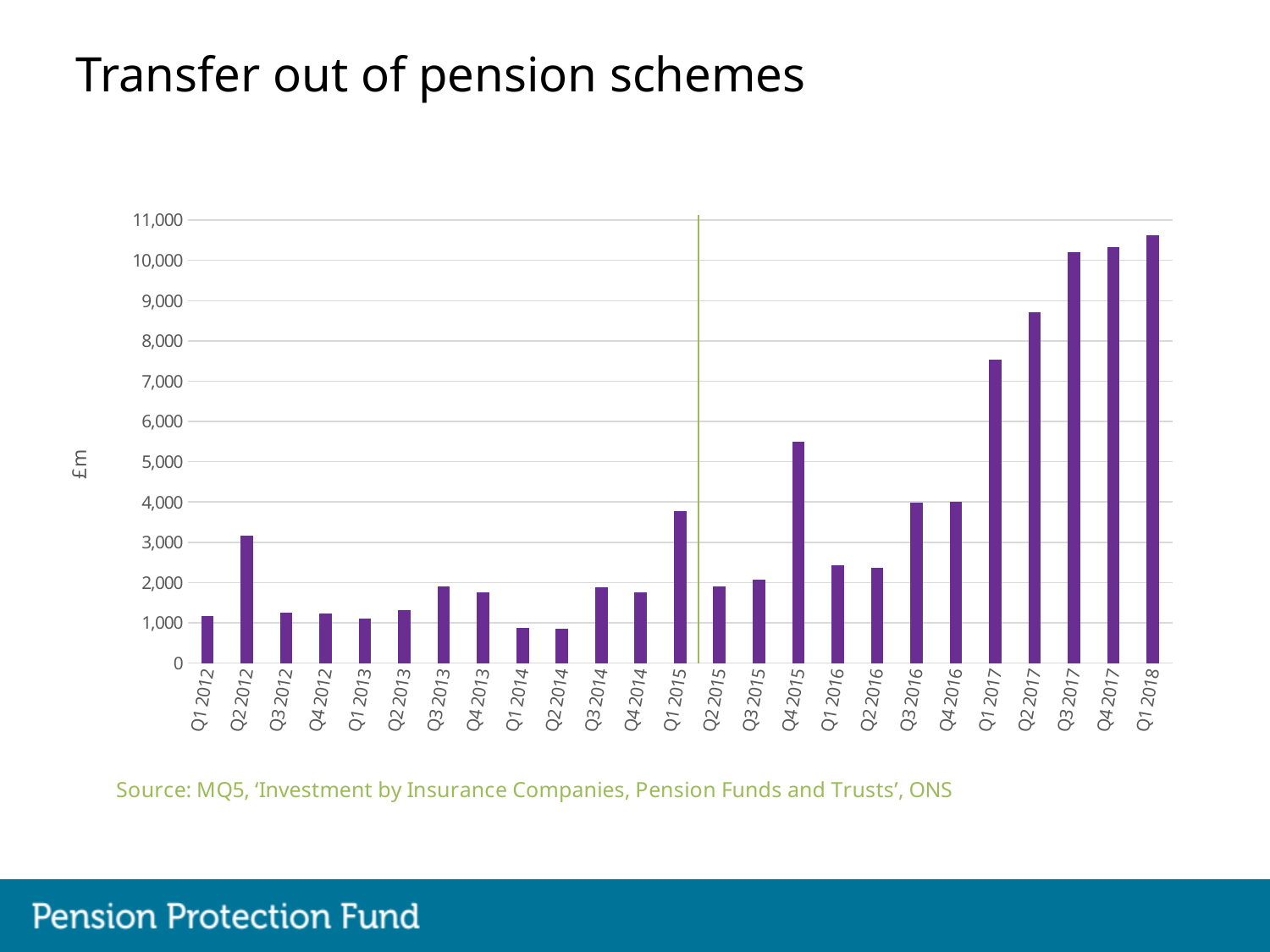
Is the value for Q2 2017 greater or less than 8,000? greater What unit is shown on the vertical axis label? £m Is the value for Q1 2015 greater or less than 4,000? less What kind of chart is shown on the slide? Bar chart How many quarters are plotted on the chart? 25 Do the values generally rise or fall from Q1 2012 to Q1 2018? Rise Which is larger, the value for Q2 2012 or the value for Q3 2012? Q2 2012 Is the value for Q3 2017 greater or less than 10,000? greater Which is larger, the value for Q4 2015 or the value for Q1 2016? Q4 2015 Which quarter has the highest value on the chart? Q1 2018